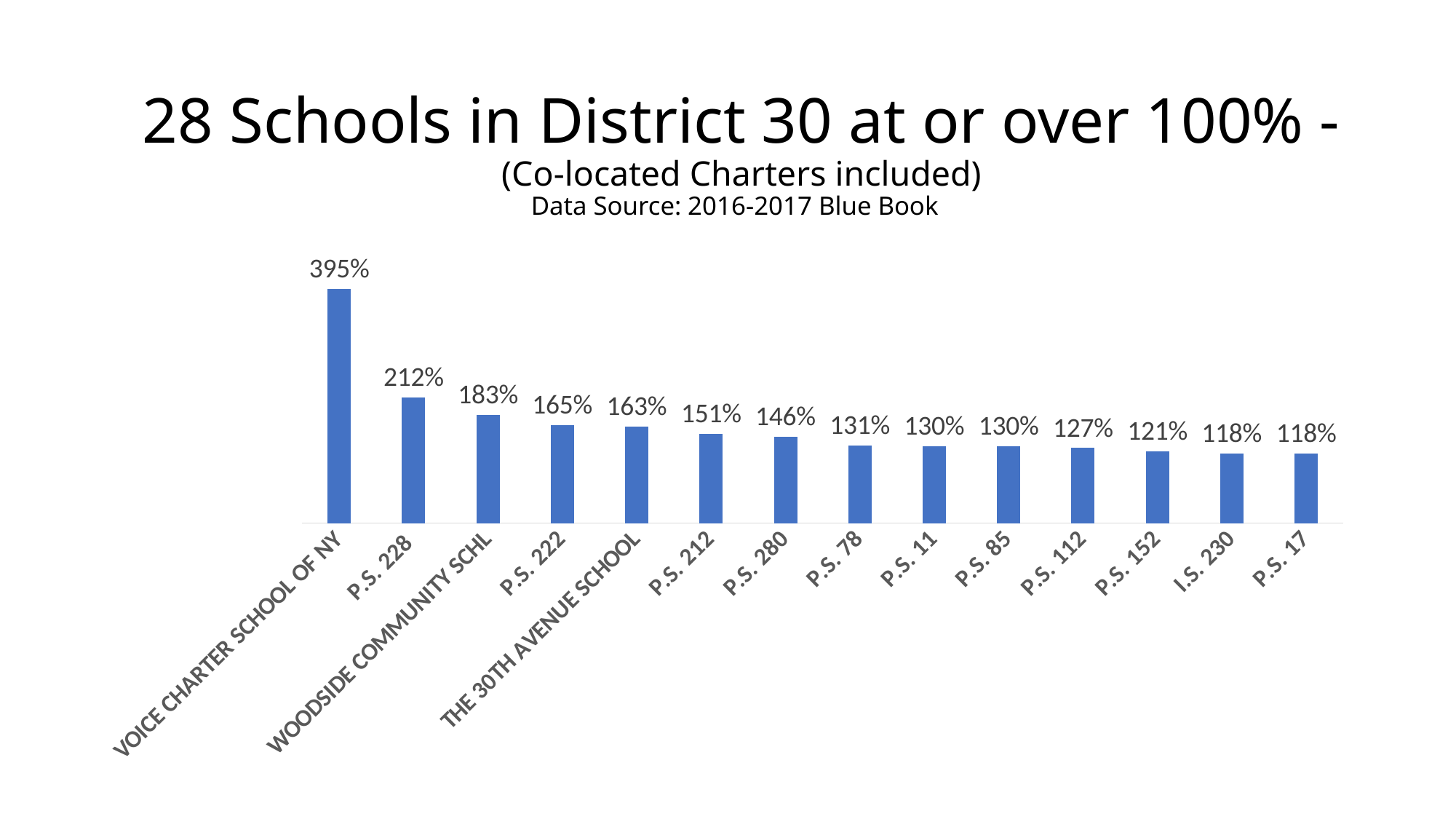
Which school has the highest value? VOICE CHARTER SCHOOL OF NY What is the value for P.S. 152? 121% What is the difference between the values for VOICE CHARTER SCHOOL OF NY and P.S. 228? 183% What is the difference between the values for P.S. 222 and P.S. 112? 38% Do the values rise or fall from left to right along the x axis? Fall What is the value for P.S. 228? 212% Which has a larger value, P.S. 212 or P.S. 78? P.S. 212 What is the value for THE 30TH AVENUE SCHOOL? 163% How many schools are shown in the chart? 14 What is the value for WOODSIDE COMMUNITY SCHL? 183% What kind of chart is shown on the slide? Bar chart What is the value for VOICE CHARTER SCHOOL OF NY? 395%